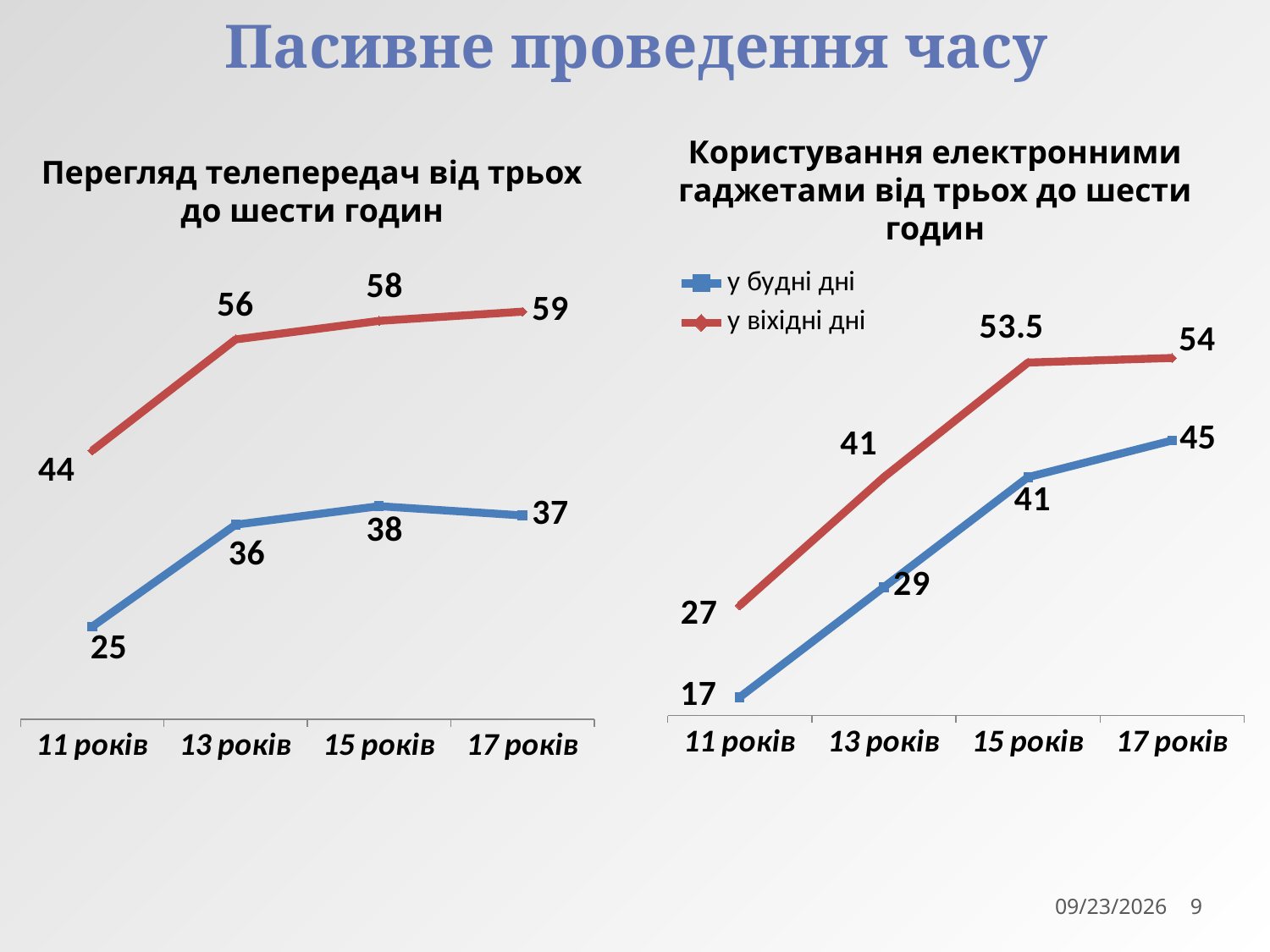
In the chart 'Перегляд телепередач від трьох до шести годин', what is the value of the blue line at 15 років? 38 In the chart 'Користування електронними гаджетами від трьох до шести годин', what is the difference between 'у віхідні дні' and 'у будні дні' at 11 років? 10 How many series does the legend of the chart 'Користування електронними гаджетами від трьох до шести годин' list? 2 In the chart 'Перегляд телепередач від трьох до шести годин', what is the difference between the red and blue lines at 13 років? 20 In the chart 'Користування електронними гаджетами від трьох до шести годин', which series has the lower value at 17 років? у будні дні In the chart 'Перегляд телепередач від трьох до шести годин', how many age categories are shown on the x axis? 4 What type of chart is 'Перегляд телепередач від трьох до шести годин'? line chart In the chart 'Користування електронними гаджетами від трьох до шести годин', what is the value for 'у будні дні' at 11 років? 17 In the chart 'Перегляд телепередач від трьох до шести годин', what is the value of the red line at 11 років? 44 In the chart 'Користування електронними гаджетами від трьох до шести годин', does the 'у будні дні' series rise or fall from 11 років to 17 років? rise In the chart 'Користування електронними гаджетами від трьох до шести годин', what is the value for 'у віхідні дні' at 15 років? 53.5 In the chart 'Перегляд телепередач від трьох до шести годин', at which age group does the red line reach its highest value? 17 років